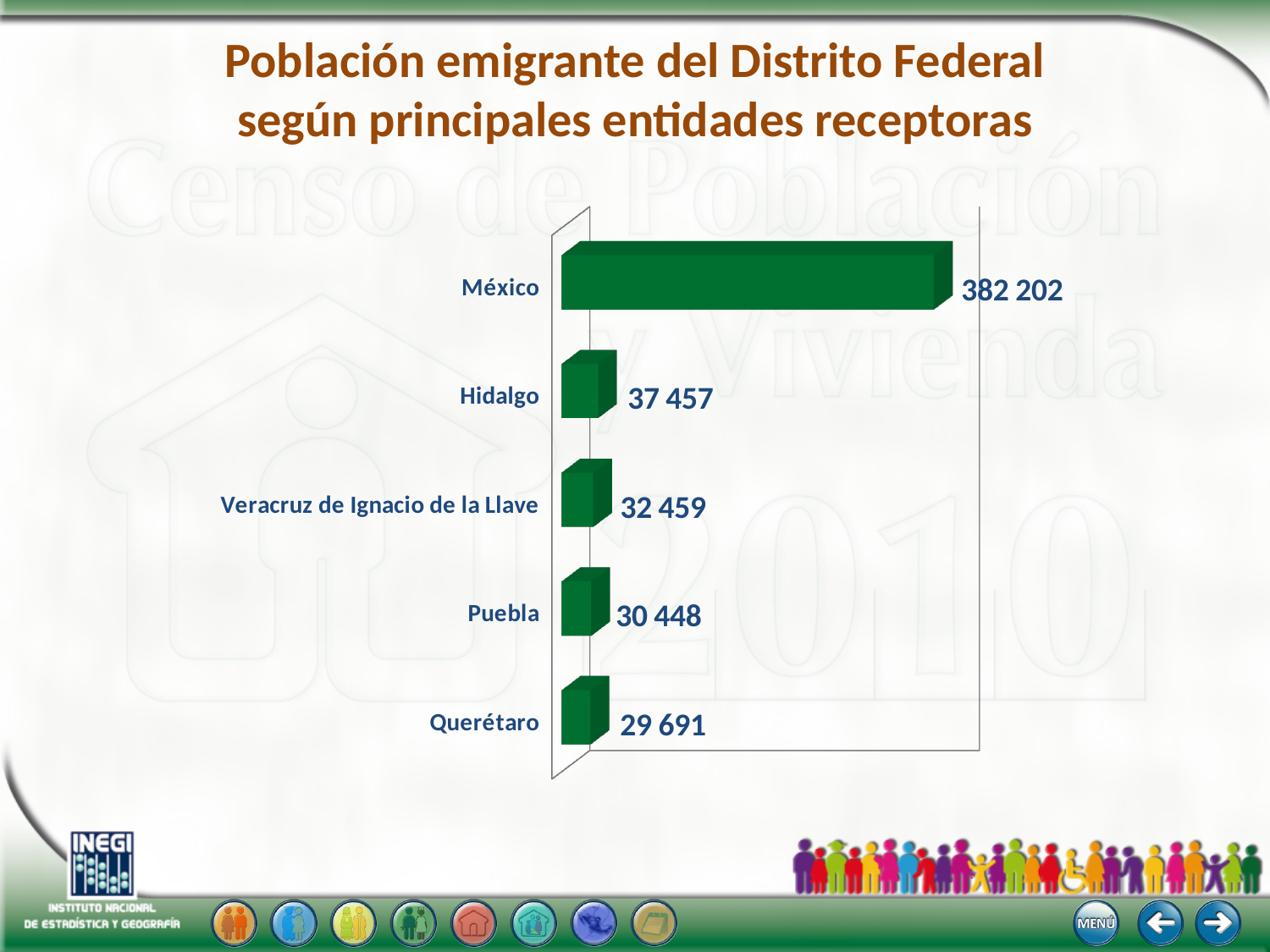
What is the value for Querétaro? 29 691 Which entity has the highest value? México Which entity has the lowest value? Querétaro What is the title of the slide? Población emigrante del Distrito Federal según principales entidades receptoras What is the value for Veracruz de Ignacio de la Llave? 32 459 Which is larger, the value for Hidalgo or the value for Veracruz de Ignacio de la Llave? Hidalgo What kind of chart is shown on the slide? Bar chart What is the value for México? 382 202 What is the difference between the values for México and Hidalgo? 344 745 What is the value for Hidalgo? 37 457 How many entities are shown in the chart? 5 What is the difference between the values for Puebla and Querétaro? 757